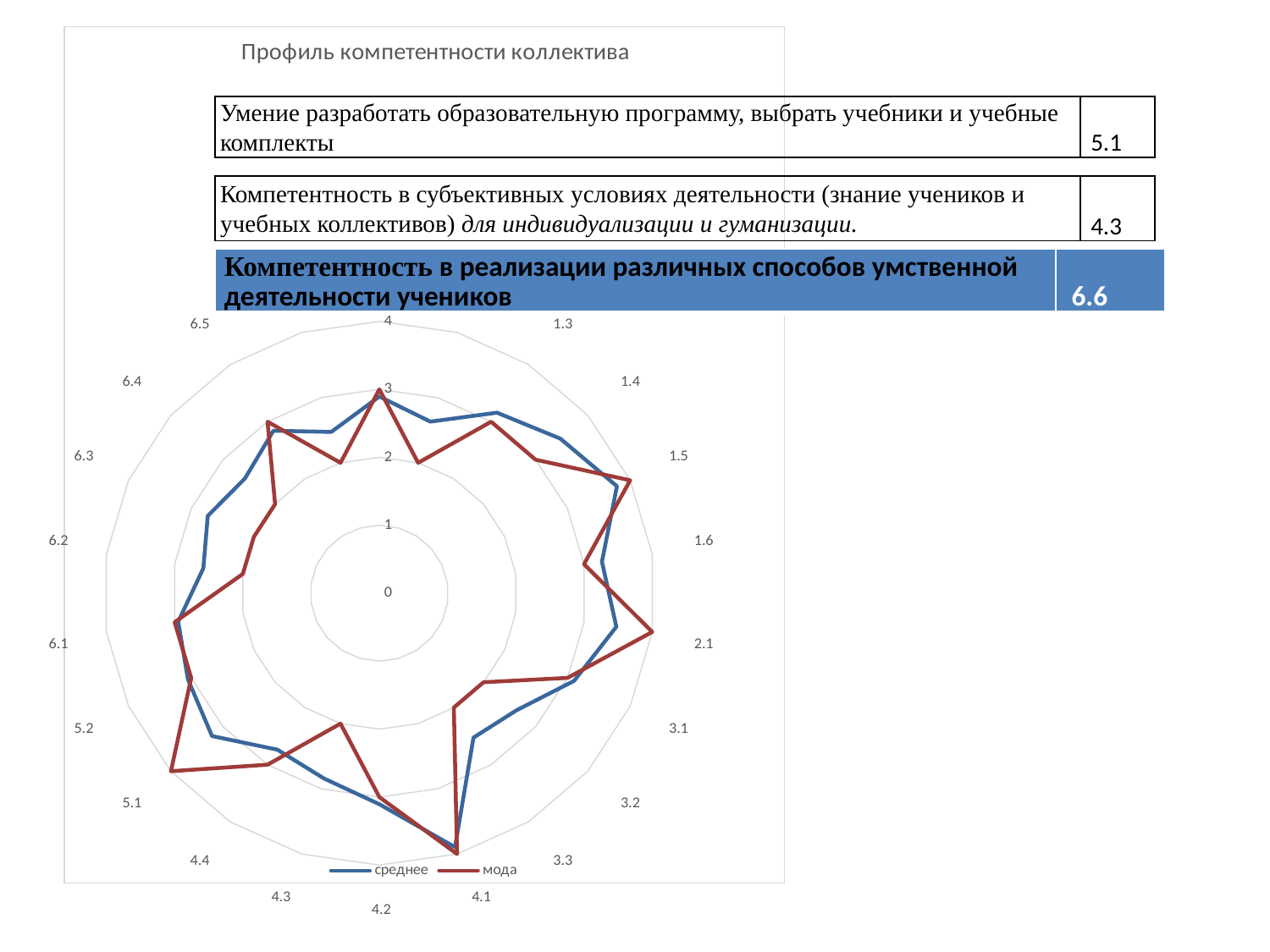
How many series does the chart legend list? 2 Is the value of the мода series for category 4.3 greater or less than 3? less Is the value of the мода series for category 4.1 greater or less than 3? greater For category 4.3, which series has the larger value, среднее or мода? среднее Is the value of the мода series for category 3.3 greater or less than 3? less Which series is drawn in red on the chart? мода What is the title of the chart? Профиль компетентности коллектива For category 2.1, which series has the larger value, среднее or мода? мода What kind of chart is shown on the slide? Radar chart